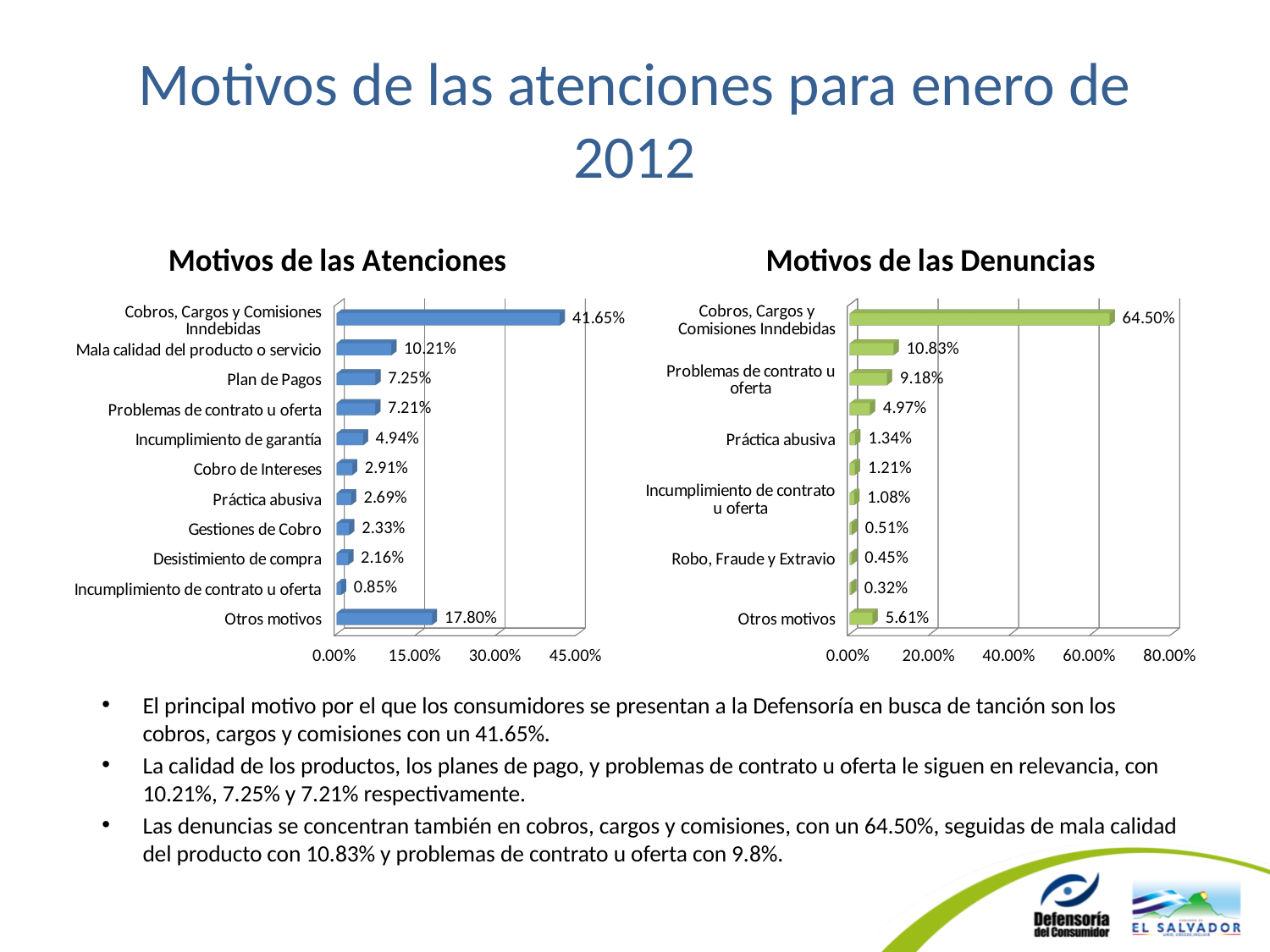
In the 'Motivos de las Denuncias' chart, what is the value for Problemas de contrato u oferta? 9.18% In the 'Motivos de las Denuncias' chart, is the value for Cobros, Cargos y Comisiones Inndebidas greater or less than 60.00%? greater In the 'Motivos de las Denuncias' chart, which category has the highest value? Cobros, Cargos y Comisiones Inndebidas In the 'Motivos de las Atenciones' chart, how many categories are shown? 11 In the 'Motivos de las Denuncias' chart, what is the value for Cobros, Cargos y Comisiones Inndebidas? 64.50% In the 'Motivos de las Atenciones' chart, what is the value for Otros motivos? 17.80% In the 'Motivos de las Atenciones' chart, what is the value for Cobros, Cargos y Comisiones Inndebidas? 41.65% In the 'Motivos de las Atenciones' chart, what is the difference between Plan de Pagos and Problemas de contrato u oferta? 0.04% In the 'Motivos de las Denuncias' chart, what is the value for Robo, Fraude y Extravio? 0.45% What type of chart is 'Motivos de las Atenciones'? Bar chart In the 'Motivos de las Atenciones' chart, which category has the lowest value? Incumplimiento de contrato u oferta In the 'Motivos de las Atenciones' chart, which is larger: Cobro de Intereses or Gestiones de Cobro? Cobro de Intereses